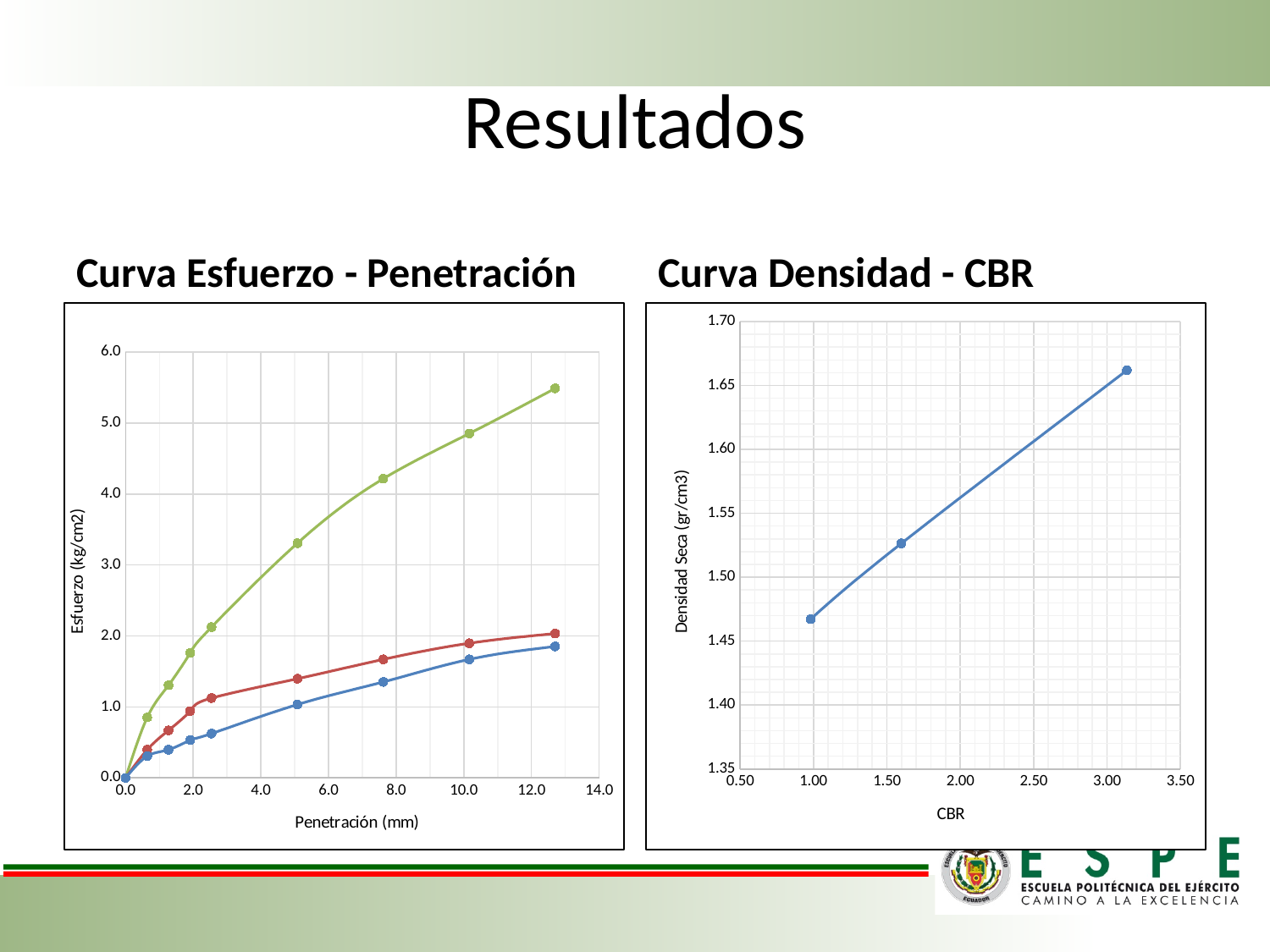
What type of chart is the "Curva Densidad - CBR" chart? line chart In the "Curva Esfuerzo - Penetración" chart, which coloured line reaches the highest Esfuerzo value? the green line What type of chart is the "Curva Esfuerzo - Penetración" chart? line chart In the "Curva Densidad - CBR" chart, is the dry density of the point with the highest CBR greater or less than 1.60 gr/cm3? greater How many lines are plotted in the "Curva Esfuerzo - Penetración" chart? 3 In the "Curva Esfuerzo - Penetración" chart, is the blue line's value at a penetration of about 5 mm greater or less than 2.0 kg/cm2? less In the "Curva Esfuerzo - Penetración" chart, is the final value of the green line greater or less than 5.0 kg/cm2? greater How many data points are plotted in the "Curva Densidad - CBR" chart? 3 In the "Curva Densidad - CBR" chart, does the dry density rise or fall as CBR increases? rises In the "Curva Esfuerzo - Penetración" chart, which coloured line has the lowest Esfuerzo values? the blue line What is the y-axis title of the "Curva Densidad - CBR" chart? Densidad Seca (gr/cm3)